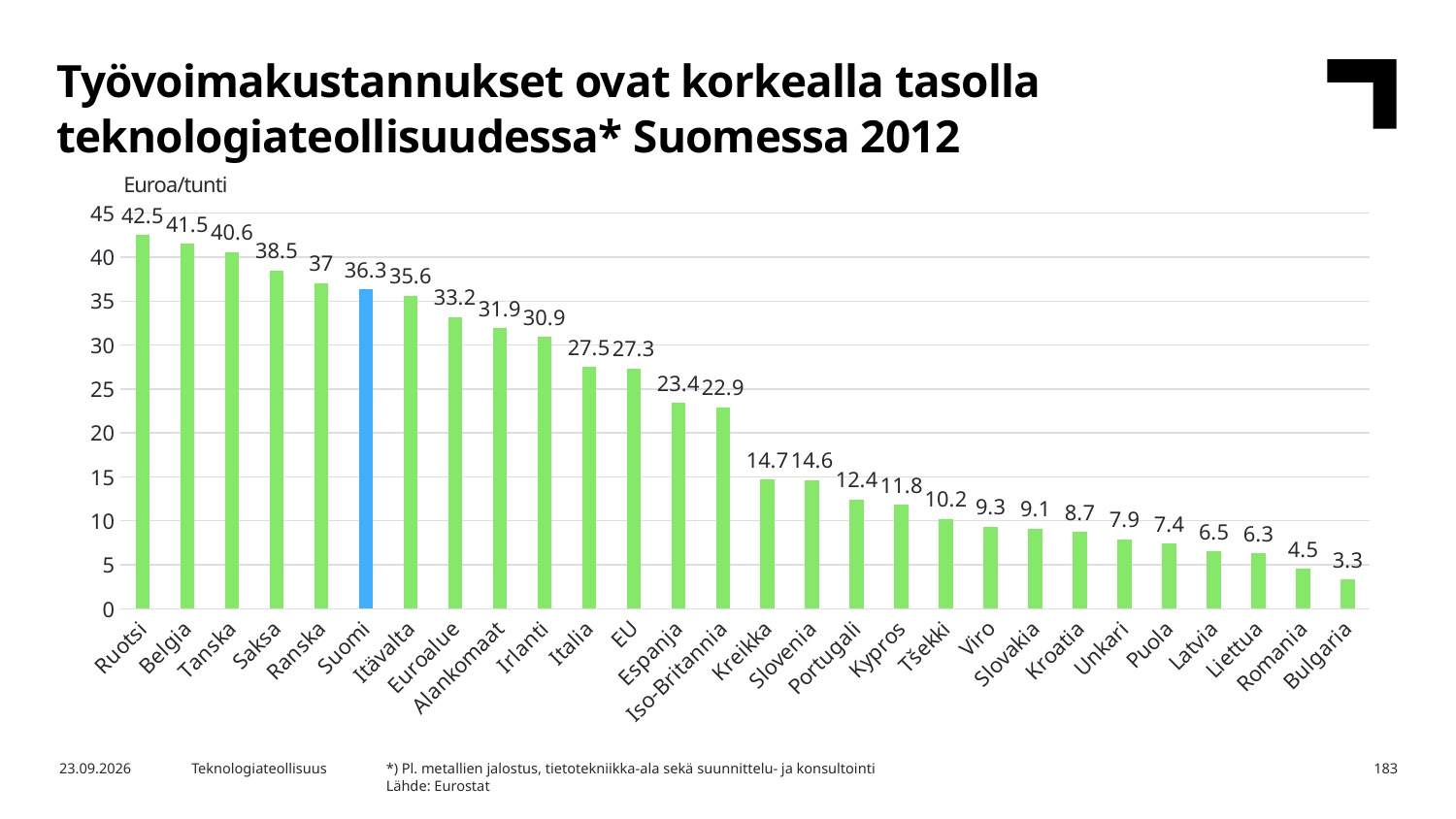
What is the value for Tšekki? 10.2 What is the value for Suomi? 36.3 Which country has the lowest value? Bulgaria What is the difference between the values for Ruotsi and Suomi? 6.2 What is the difference between the values for Euroalue and EU? 5.9 Which is larger, the value for Saksa or the value for Ranska? Saksa What is the value for Iso-Britannia? 22.9 Is the value for Kreikka greater or less than 15? less Which bar is shown in a different colour (blue) from the others? Suomi What kind of chart is shown on the slide? bar chart Which country has the highest value? Ruotsi How many countries or regions are shown on the chart? 28